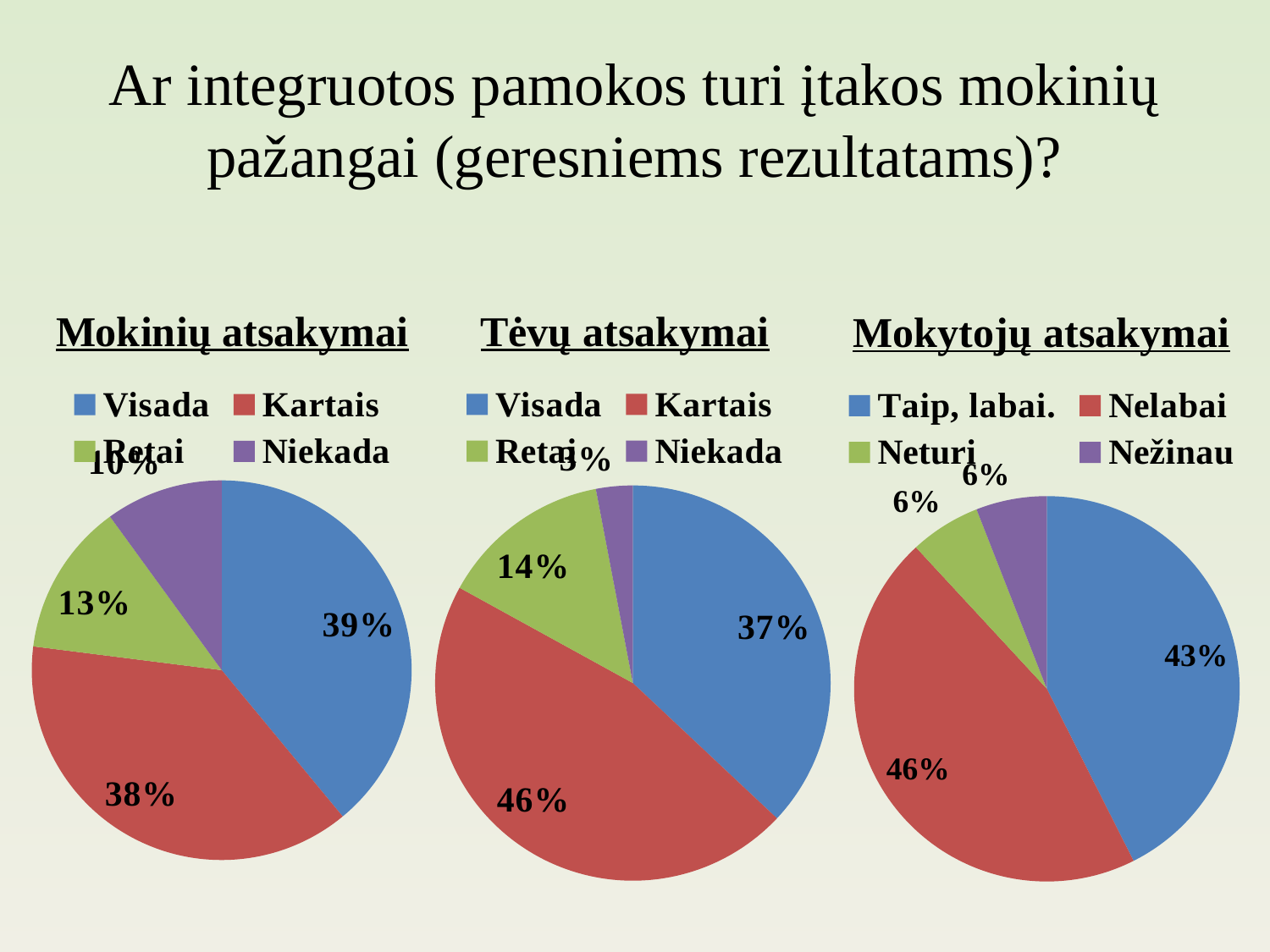
In the Mokinių atsakymai chart, which category has the smallest slice? Niekada How many pie charts are on the slide? 3 In the Mokinių atsakymai chart, what share is labelled for Visada? 39% In the Mokytojų atsakymai chart, what share is labelled for Neturi? 6% In the Mokytojų atsakymai chart, which is larger, Taip, labai. or Nelabai? Nelabai In the Tėvų atsakymai chart, what is the difference between the Kartais and Visada shares? 9% How many categories does the legend of the Mokytojų atsakymai chart list? 4 In the Mokinių atsakymai chart, what share is labelled for Retai? 13% In the Mokytojų atsakymai chart, what share is labelled for Nelabai? 46% What kind of charts are shown on the slide? Pie charts In the Tėvų atsakymai chart, which category has the largest slice? Kartais In the Tėvų atsakymai chart, what share is labelled for Kartais? 46%